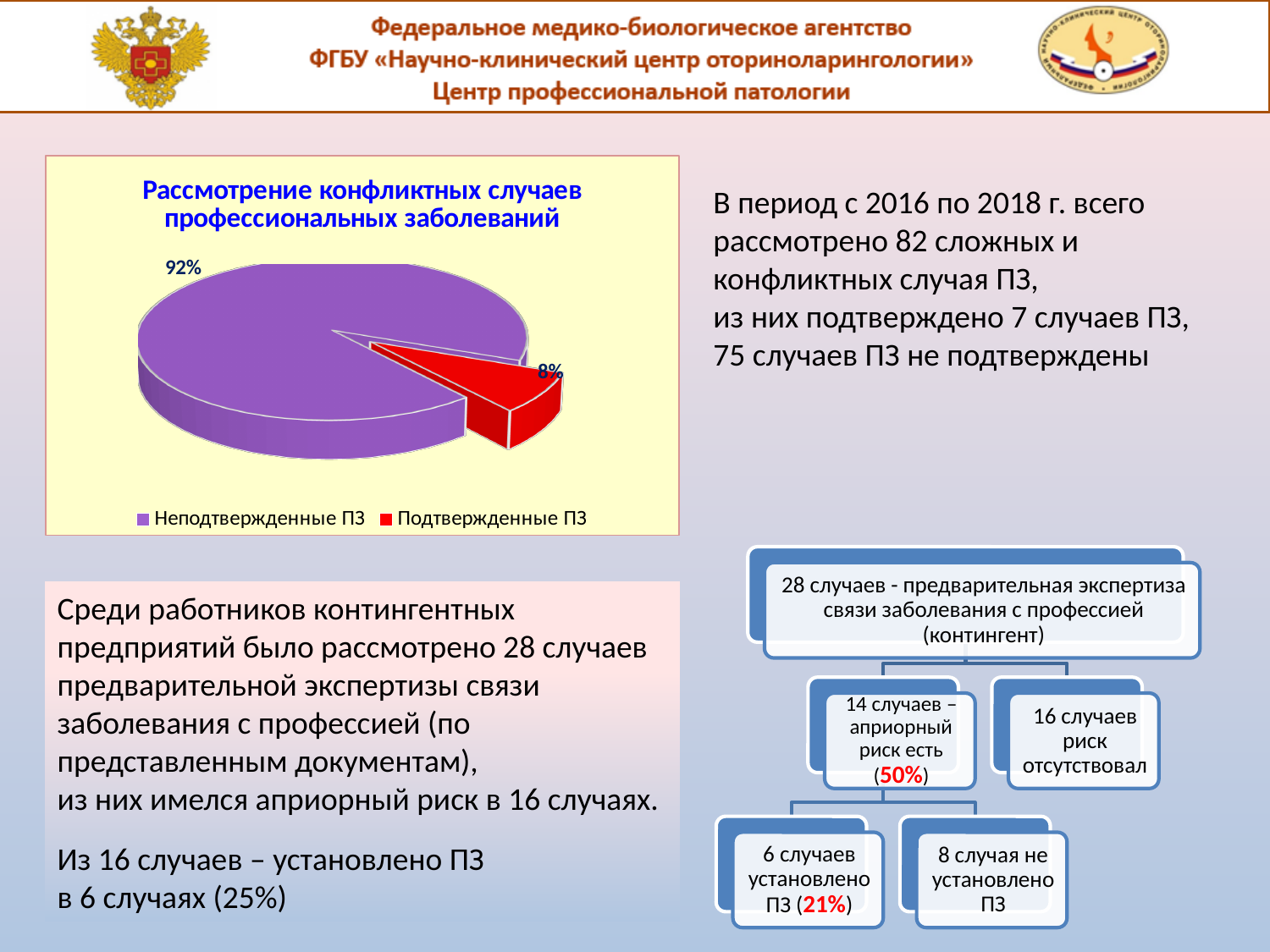
What share of the pie does "Подтвержденные ПЗ" take? 8% What colour is the "Подтвержденные ПЗ" slice in the pie chart? Red What is the difference in percentage points between the "Неподтвержденные ПЗ" and "Подтвержденные ПЗ" slices? 84 percentage points Which slice of the pie chart is the largest? Неподтвержденные ПЗ What kind of chart is shown on the slide? Pie chart Which slice of the pie chart is the smallest? Подтвержденные ПЗ Which is larger in the pie chart: "Подтвержденные ПЗ" or "Неподтвержденные ПЗ"? Неподтвержденные ПЗ How many slices does the pie chart have? 2 How many entries does the legend of the pie chart list? 2 What share of the pie does "Неподтвержденные ПЗ" take? 92% What is the title of the pie chart? Рассмотрение конфликтных случаев профессиональных заболеваний